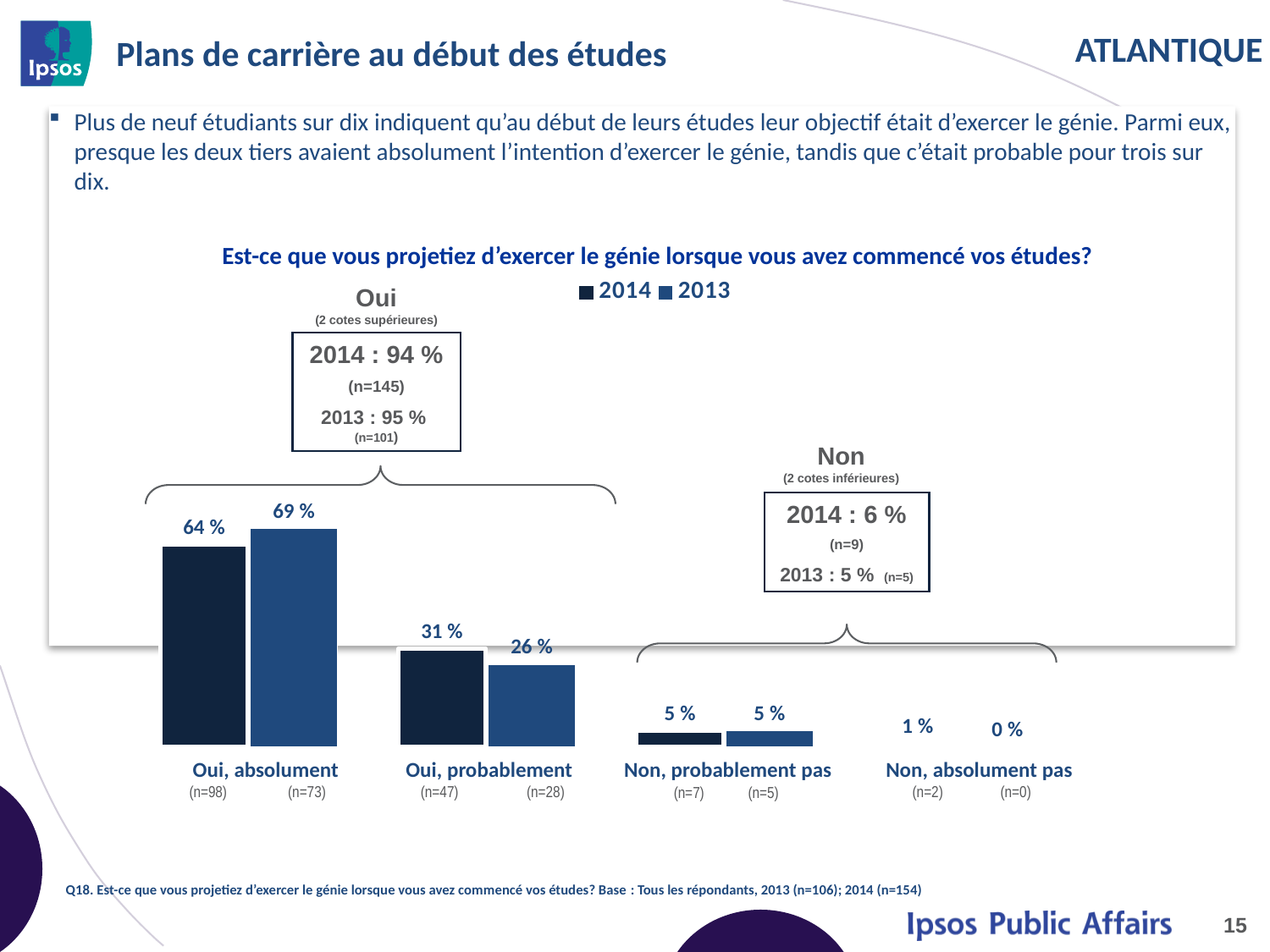
Which category has the highest value for the 2013 series? Oui, absolument How many series does the legend list? 2 What kind of chart is shown on the slide? Bar chart What is the value for 2014 in the 'Oui, probablement' category? 31 % What is the value for 2013 in the 'Oui, absolument' category? 69 % What is the value for 2014 in the 'Oui, absolument' category? 64 % What is the value for 2013 in the 'Non, absolument pas' category? 0 % What is the difference between the 2014 and 2013 values for 'Oui, probablement'? 5 % Which category has the lowest value for the 2014 series? Non, absolument pas What is the difference between the 2013 and 2014 values for 'Oui, absolument'? 5 % How many categories are shown on the x axis of the chart? 4 Which is larger for 'Oui, probablement': the 2014 value or the 2013 value? 2014